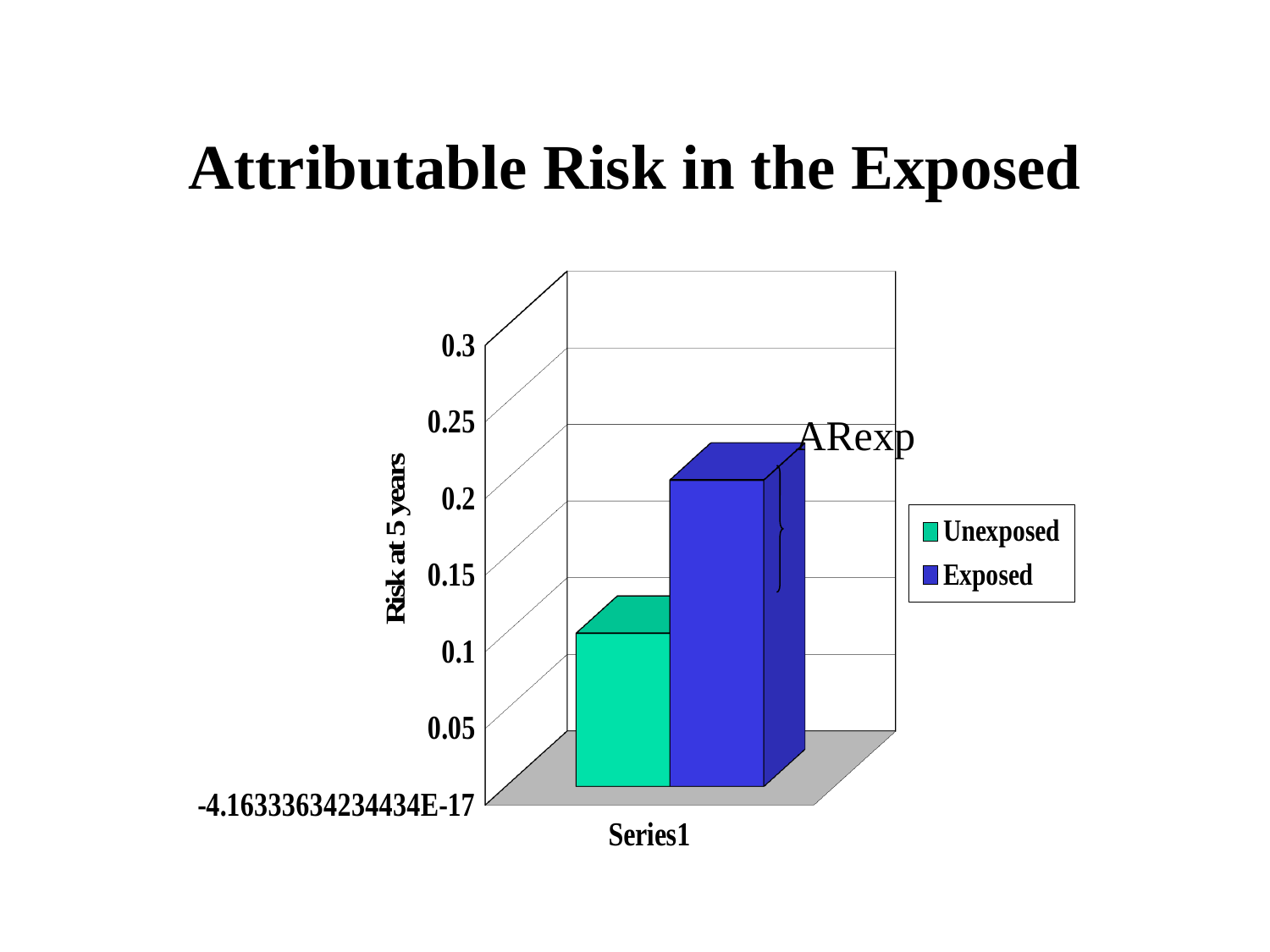
Which series has the highest risk at 5 years? Exposed How many series does the legend list? 2 What is the label of the vertical axis? Risk at 5 years Which series has the lowest risk at 5 years? Unexposed How many categories are shown on the x axis? 1 What kind of chart is shown on the slide? bar chart Is the value for Unexposed greater or less than 0.05? greater Is the value for Unexposed greater or less than 0.15? less Is the value for Exposed greater or less than 0.25? less Which series has the taller bar, Unexposed or Exposed? Exposed What is the title of the chart? Attributable Risk in the Exposed